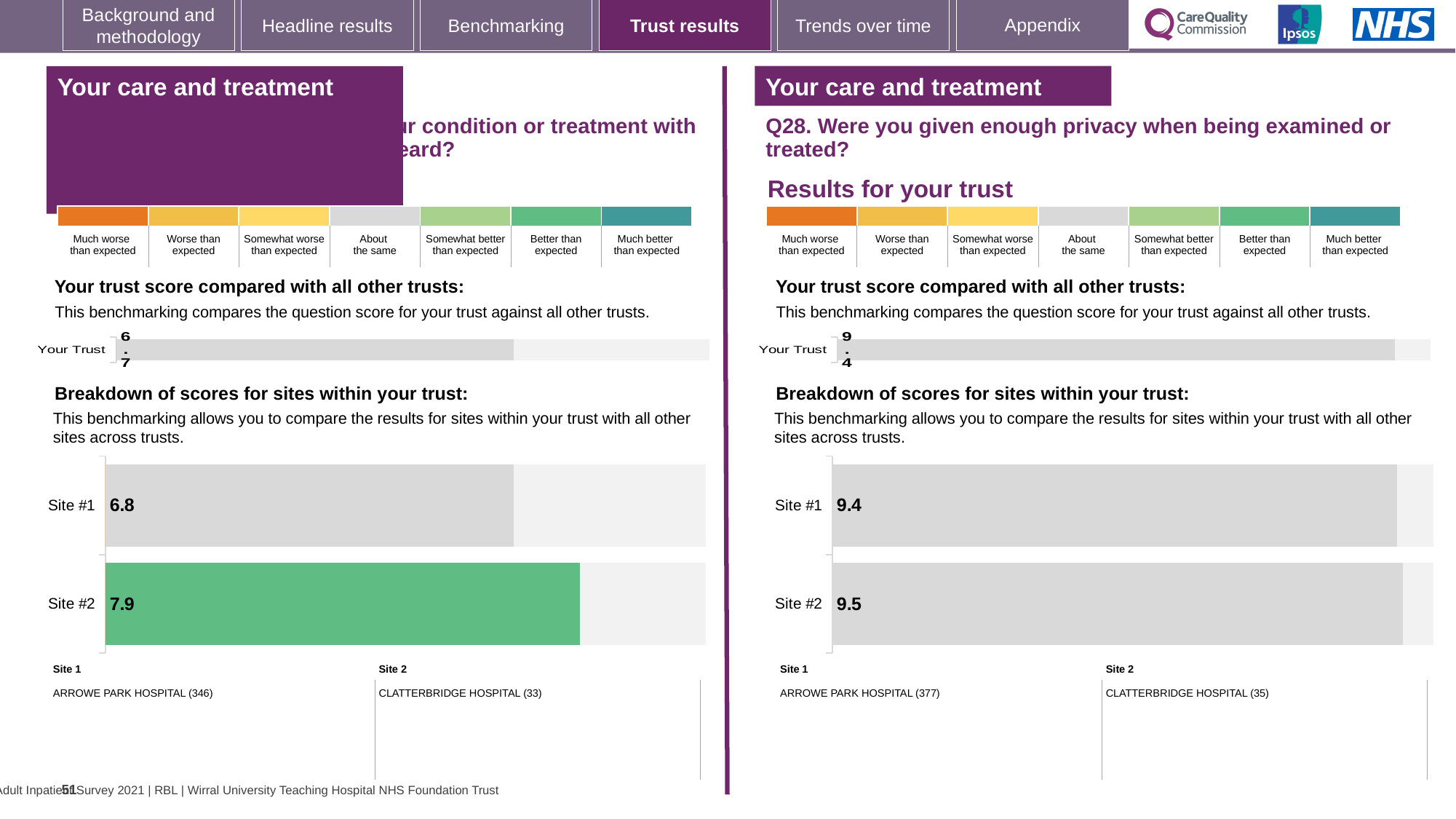
On the left-hand site breakdown chart, what is the difference between the Site #2 and Site #1 scores? 1.1 What type of chart is the left-hand site breakdown chart? Bar chart On the left-hand 'Your trust score compared with all other trusts' chart, what is the score for Your Trust? 6.7 On the left-hand site breakdown chart, what colour is the bar for Site #2? Green On the right-hand (Q28) 'Breakdown of scores for sites within your trust' chart, what is the score for Site #1? 9.4 On the right-hand (Q28) 'Your trust score compared with all other trusts' chart, what is the score for Your Trust? 9.4 On the left-hand 'Breakdown of scores for sites within your trust' chart, what is the score for Site #2? 7.9 On the left-hand 'Breakdown of scores for sites within your trust' chart, what is the score for Site #1? 6.8 On the right-hand (Q28) site breakdown chart, what is the difference between the Site #2 and Site #1 scores? 0.1 How many sites are shown on the right-hand (Q28) site breakdown chart? 2 On the right-hand (Q28) 'Breakdown of scores for sites within your trust' chart, what is the score for Site #2? 9.5 On the left-hand site breakdown chart, which site has the higher score? Site #2